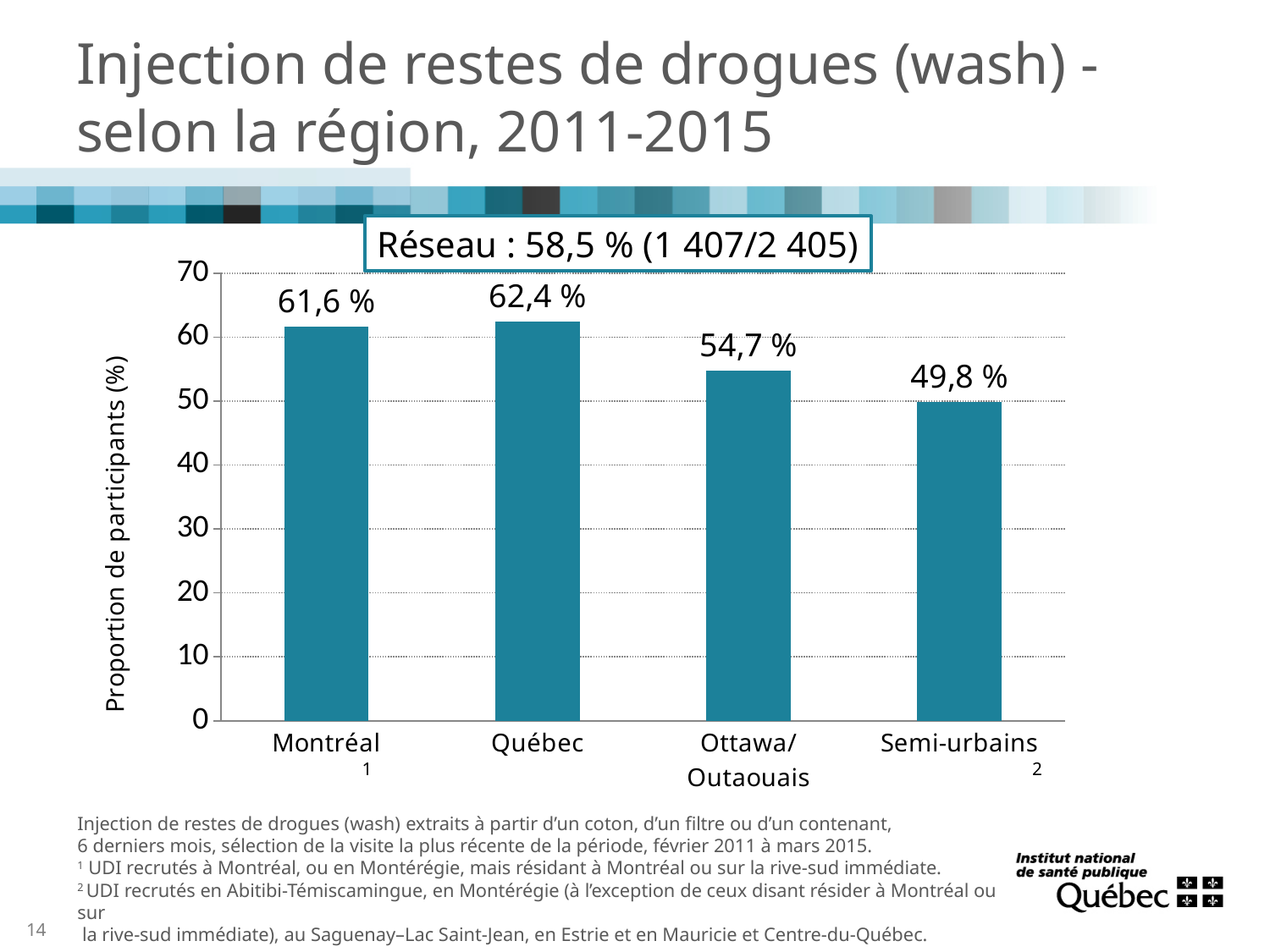
What is the label of the y axis? Proportion de participants (%) Which region has the highest value? Québec What is the difference between the values for Québec and Semi-urbains? 12,6 % What kind of chart is shown on the slide? Bar chart Which region has the lowest value? Semi-urbains How many regions are shown on the chart? 4 What is the value for Montréal? 61,6 % What is the value for Québec? 62,4 % What is the value for Ottawa/Outaouais? 54,7 % Which is larger, the value for Montréal or the value for Ottawa/Outaouais? Montréal What is the value for Semi-urbains? 49,8 % What is the overall network (Réseau) value shown in the box above the chart? 58,5 % (1 407/2 405)